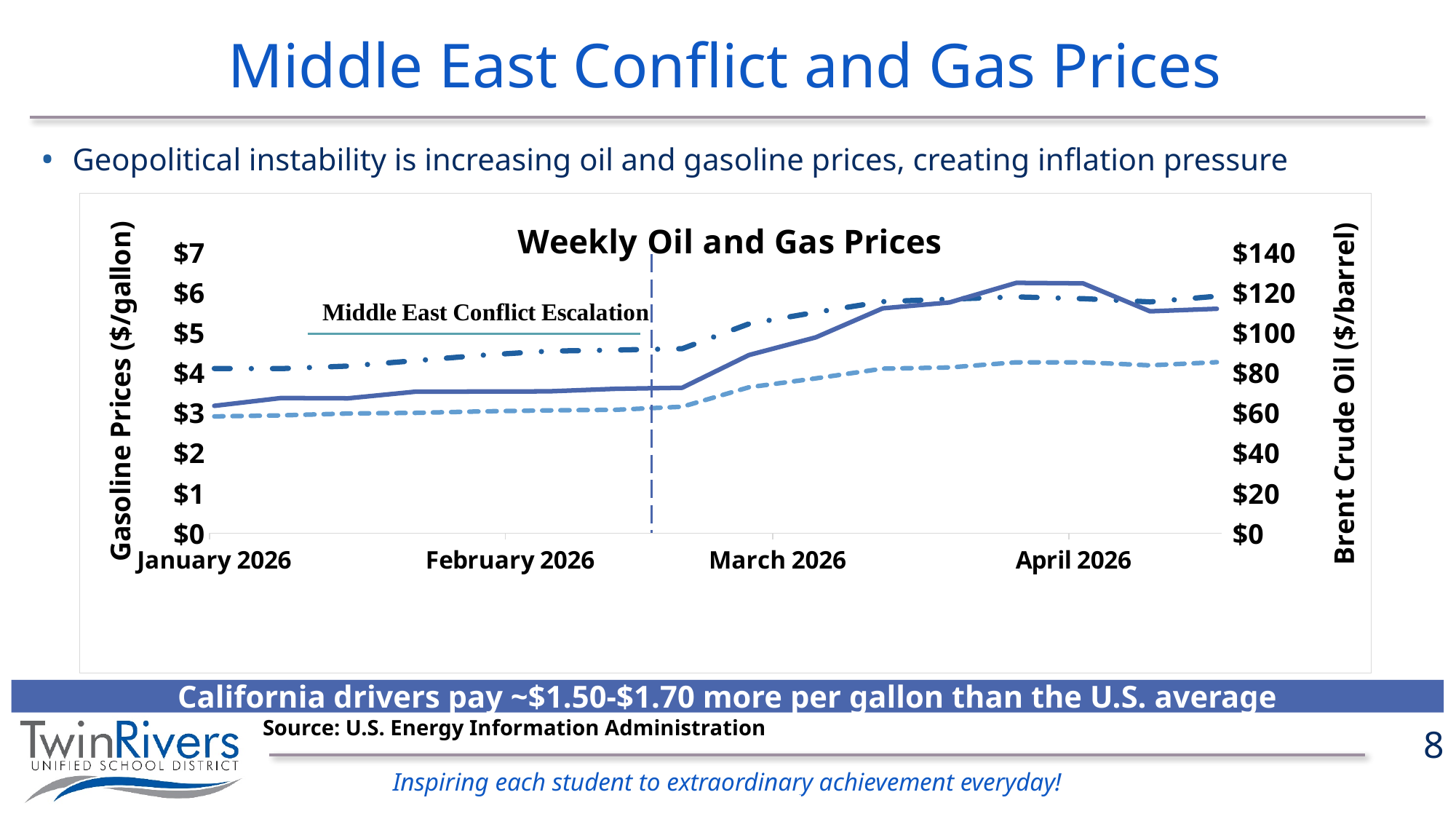
What is the highest tick value shown on the right vertical axis of the chart? $140 Read against the left axis, is the dashed line's value at April 2026 greater or less than $3? greater How many lines are plotted on the chart? 3 Does the solid line rise or fall overall from January 2026 to April 2026? Rise Read against the left axis, is the dashed line's value at January 2026 greater or less than $4? less What is the label of the left vertical axis of the chart? Gasoline Prices ($/gallon) Does the dashed line rise or fall overall from January 2026 to April 2026? Rise Read against the left axis, is the solid line's value at April 2026 greater or less than $5? greater How many month labels are shown along the x axis of the chart? 4 What kind of chart is shown on the slide? Line chart What is the title of the chart? Weekly Oil and Gas Prices